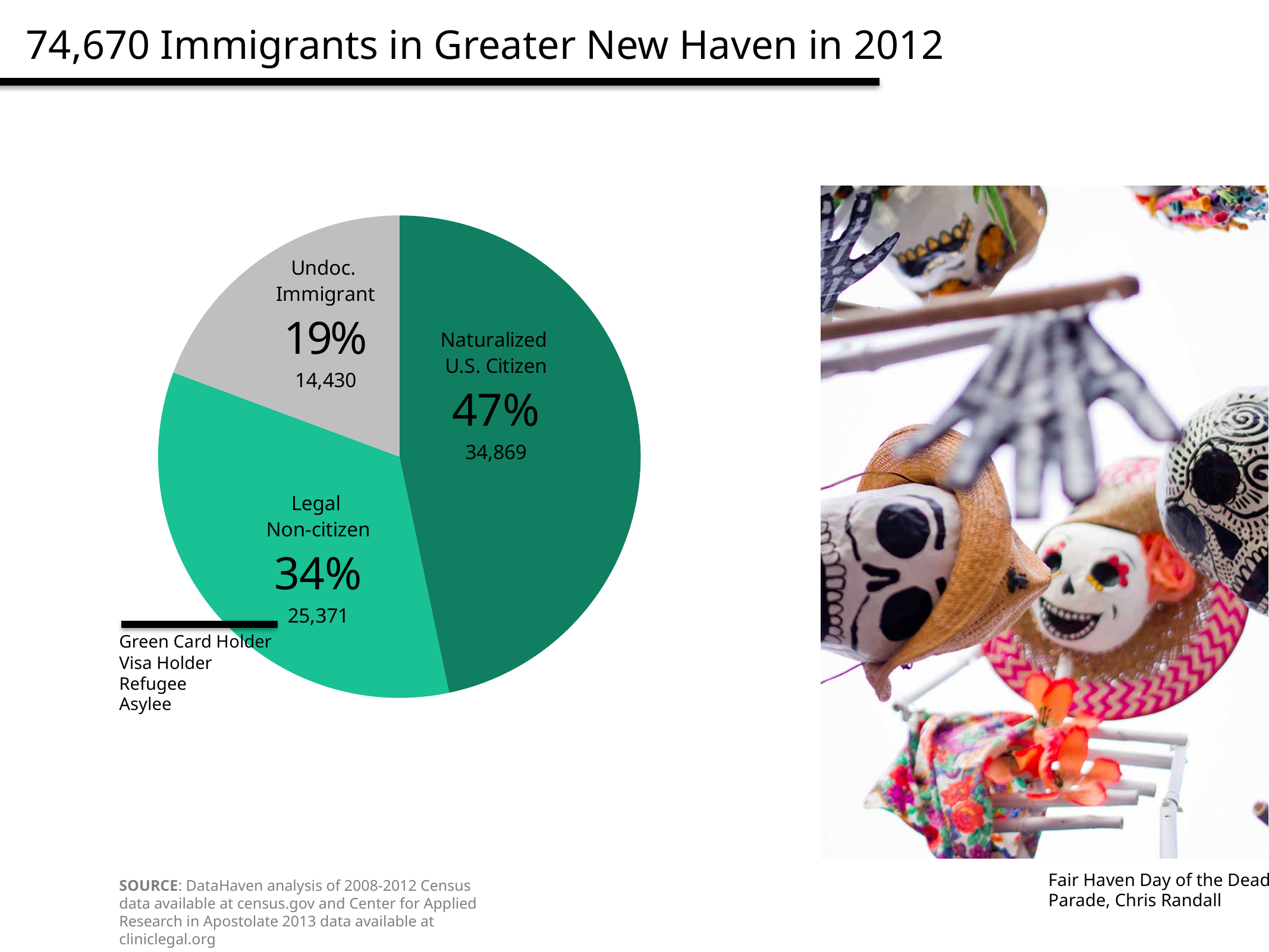
How many immigrants are Legal Non-citizens according to the chart? 25,371 How many slices does the pie chart have? 3 What percentage of immigrants are Legal Non-citizens? 34% What is the number of Undocumented Immigrants shown on the chart? 14,430 Which category has the smallest share of the pie? Undoc. Immigrant What is the difference in percentage points between Naturalized U.S. Citizens and Undocumented Immigrants? 28 What is the title of the slide containing the pie chart? 74,670 Immigrants in Greater New Haven in 2012 What percentage of immigrants are Naturalized U.S. Citizens? 47% Which is larger: the number of Legal Non-citizens or the number of Undocumented Immigrants? Legal Non-citizen What is the difference in count between Naturalized U.S. Citizens and Legal Non-citizens? 9,498 Which category has the largest share of the pie? Naturalized U.S. Citizen What type of chart is shown on the slide? Pie chart